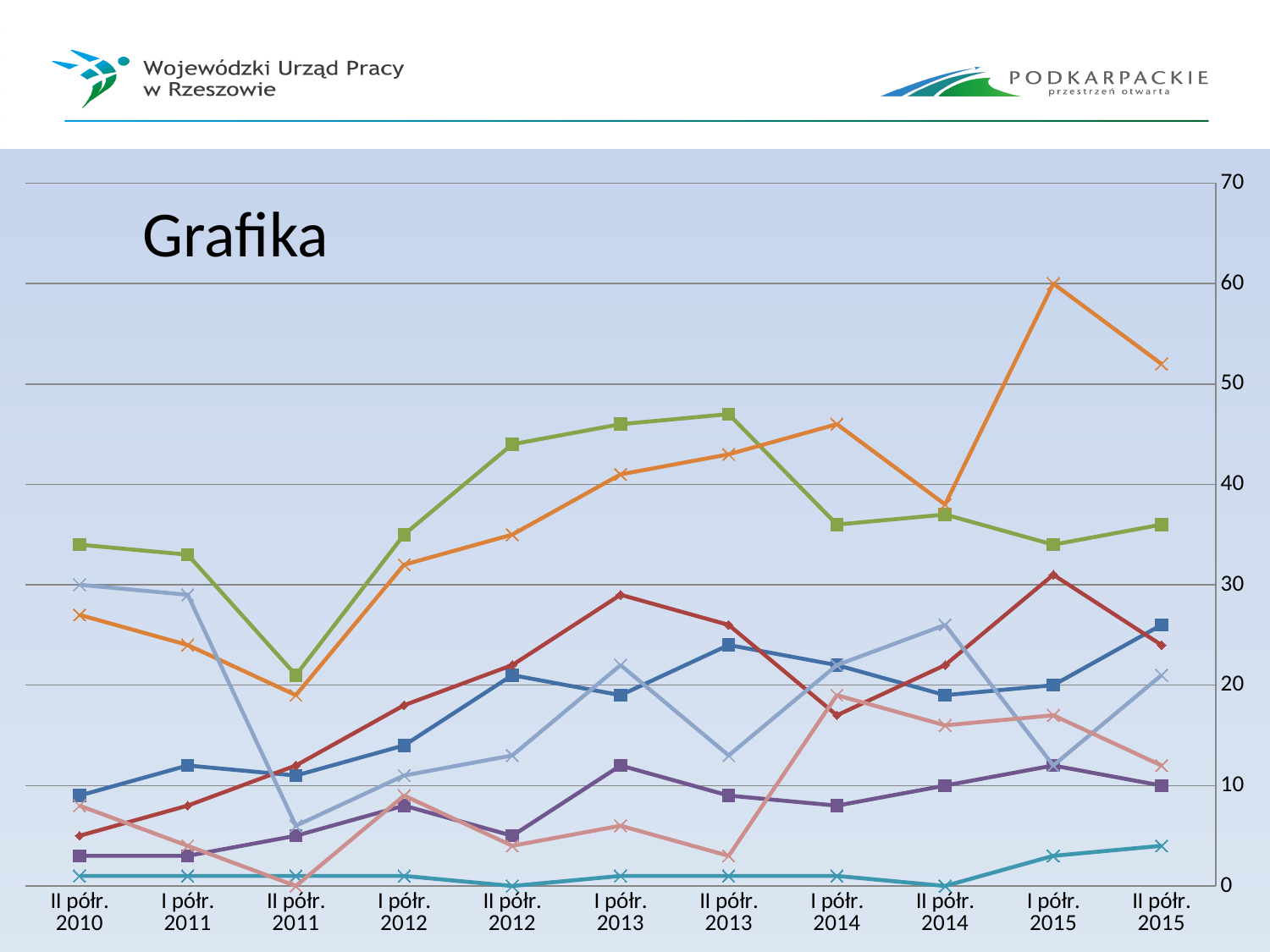
Does the chart include a legend naming the series? No What is the title shown on the chart? Grafika Is the highest value plotted on the chart greater or less than 50? greater What kind of chart is shown on the slide? line chart What is the last period shown on the x axis of the chart? II półr. 2015 What is the first period shown on the x axis of the chart? II półr. 2010 How many periods are shown along the x axis of the chart? 11 How many periods on the x axis are labelled with the year 2013? 2 In which period does the chart reach its highest plotted value? I półr. 2015